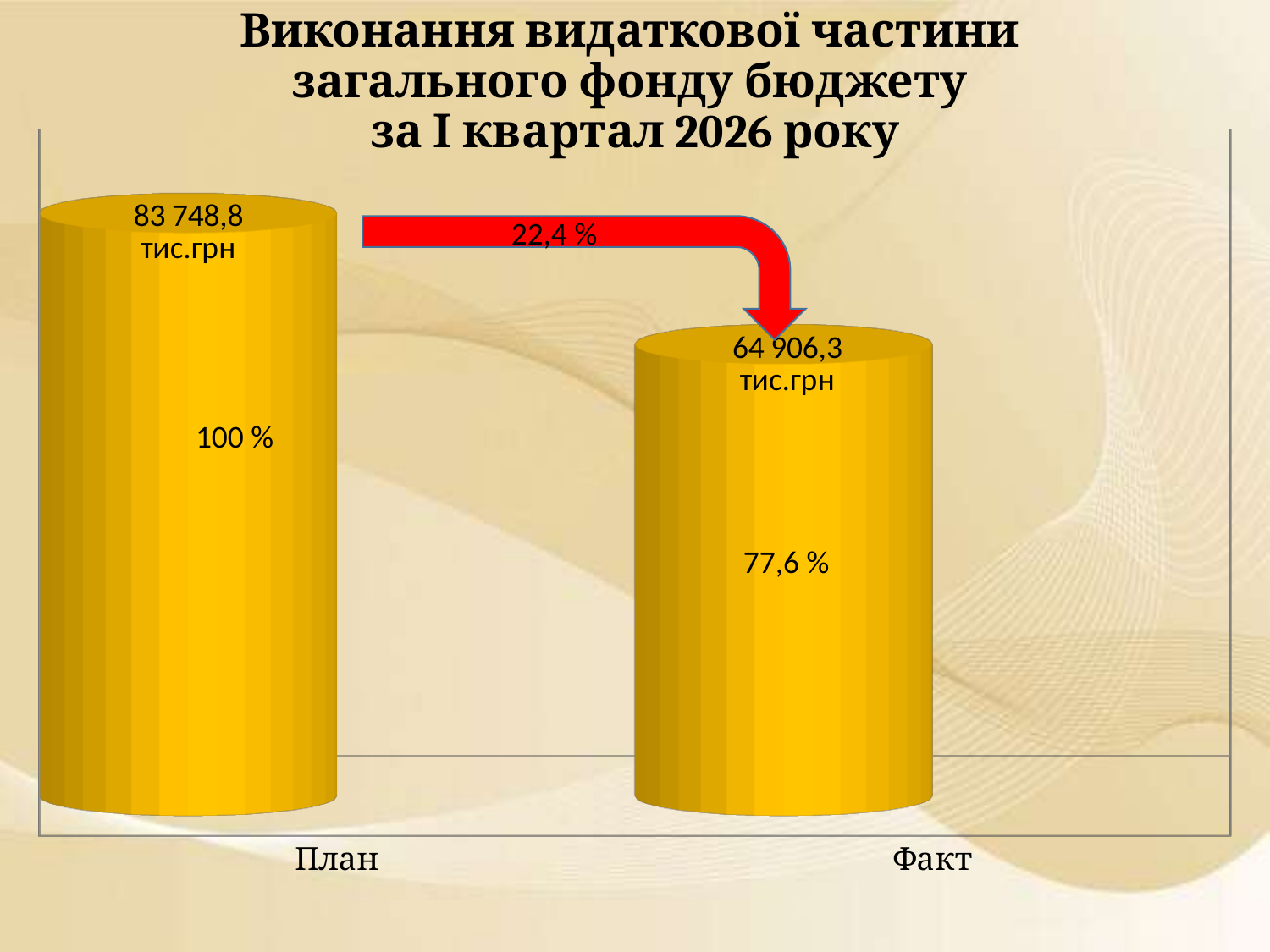
What percentage is shown on the Факт bar? 77,6 % How many categories are shown on the chart? 2 What percentage is written on the red arrow between the two bars? 22,4 % Which category has the higher value, План or Факт? План Which category has the lowest value? Факт What is the value for Факт? 64 906,3 тис.грн What is the value for План? 83 748,8 тис.грн What is the difference between the План and Факт values in тис.грн? 18 842,5 тис.грн What is the title of the chart? Виконання видаткової частини загального фонду бюджету за І квартал 2026 року By how many percentage points is Факт below План? 22,4 % What kind of chart is shown on the slide? Bar chart What percentage is shown on the План bar? 100 %